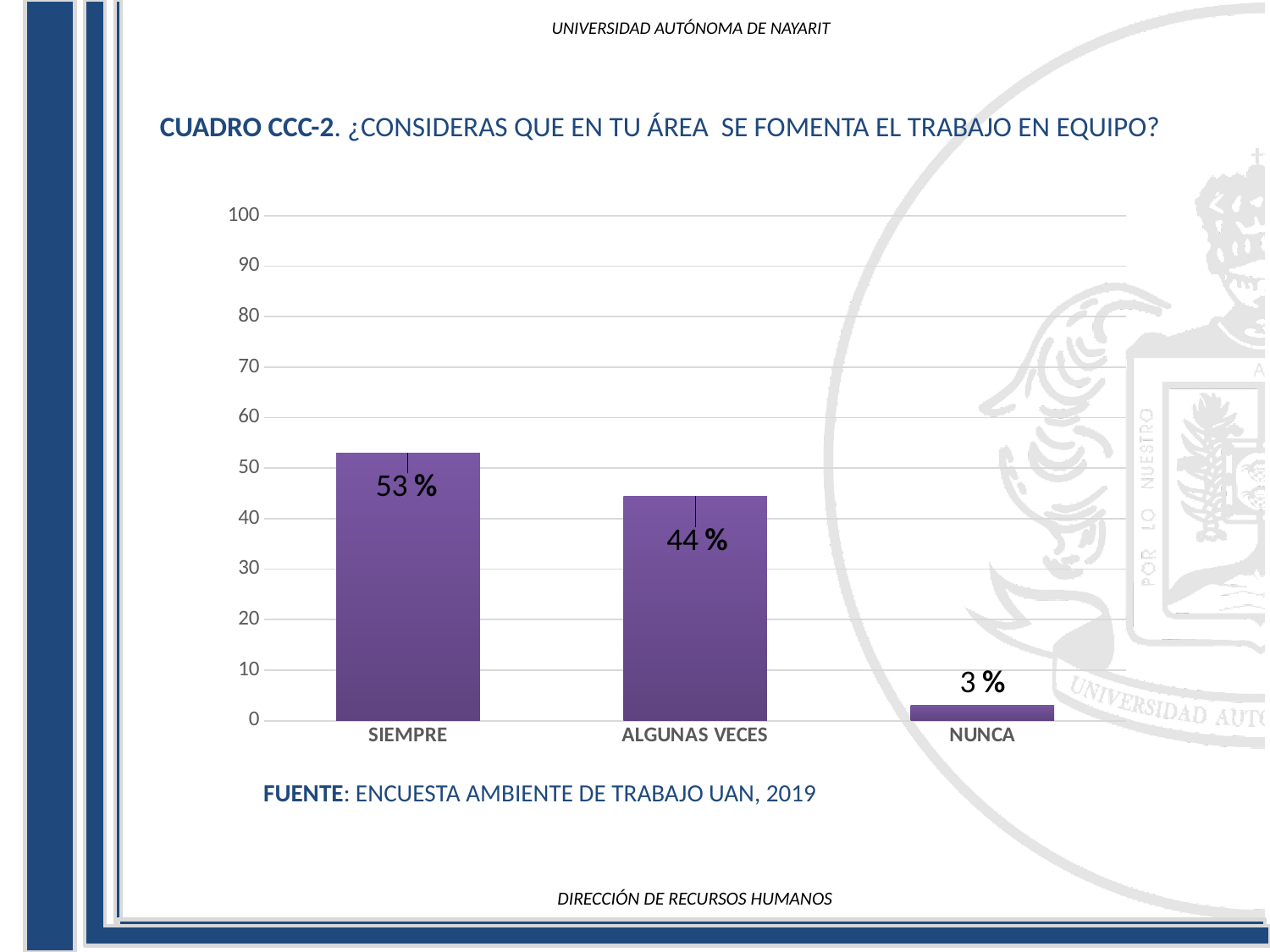
Is the value for ALGUNAS VECES greater or less than 50? less What is the source cited below the chart? ENCUESTA AMBIENTE DE TRABAJO UAN, 2019 How many categories are shown on the x axis? 3 What is the value for NUNCA? 3 % Which is larger, the value for ALGUNAS VECES or the value for NUNCA? ALGUNAS VECES What is the difference between the values for SIEMPRE and ALGUNAS VECES? 9 % What is the value for ALGUNAS VECES? 44 % What is the value for SIEMPRE? 53 % Do the values rise or fall from left to right along the x axis? fall Which category has the lowest value? NUNCA What kind of chart is shown on the slide? bar chart Which category has the highest value? SIEMPRE